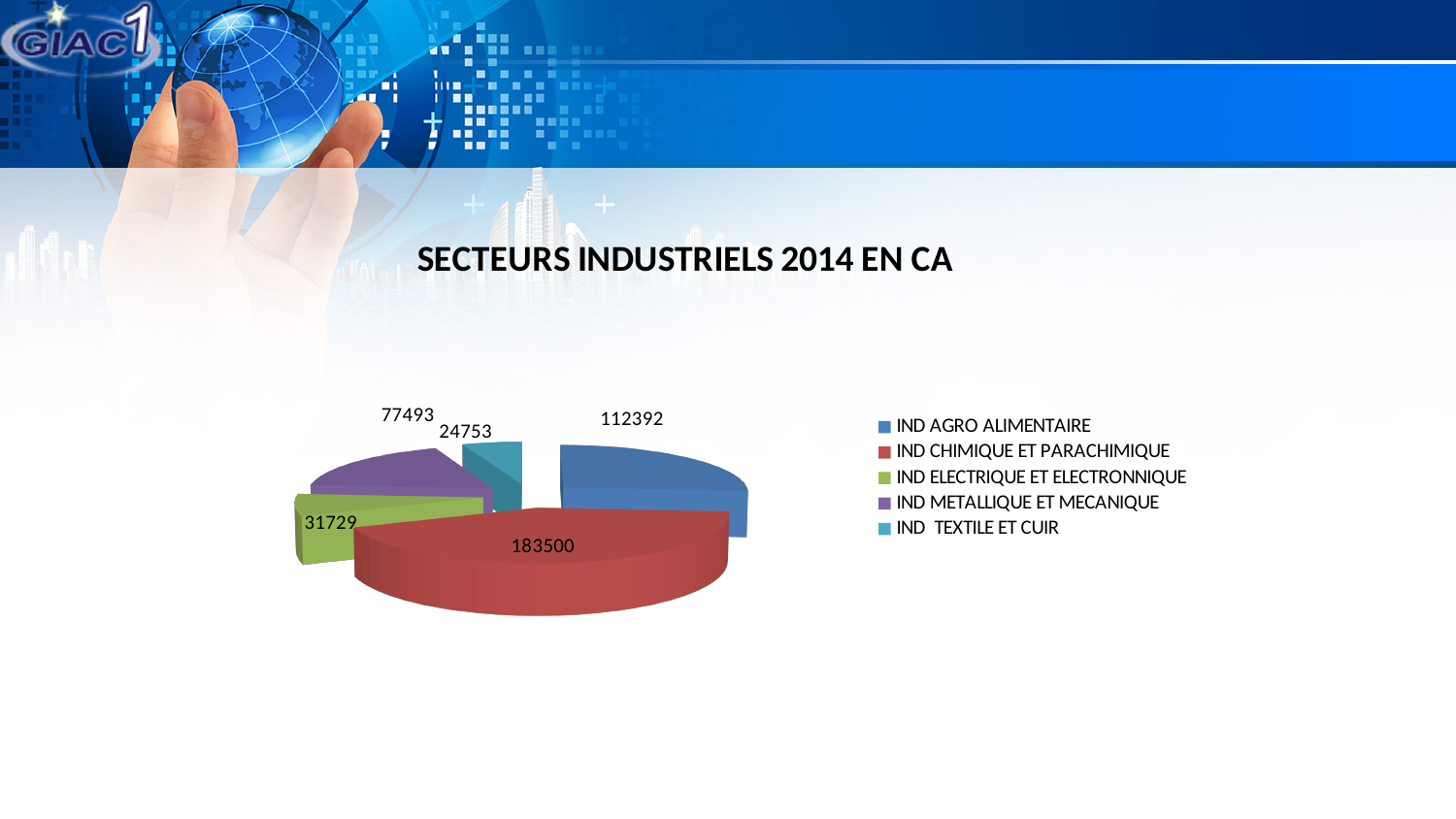
Which sector has the largest slice of the pie? IND CHIMIQUE ET PARACHIMIQUE What type of chart is shown on the slide? Pie chart What is the value for IND CHIMIQUE ET PARACHIMIQUE? 183500 Which sector has the smallest slice of the pie? IND TEXTILE ET CUIR What is the value for IND TEXTILE ET CUIR? 24753 What is the title of the chart? SECTEURS INDUSTRIELS 2014 EN CA What is the value for IND METALLIQUE ET MECANIQUE? 77493 What is the difference between the values for IND CHIMIQUE ET PARACHIMIQUE and IND AGRO ALIMENTAIRE? 71108 Which is larger, the value for IND METALLIQUE ET MECANIQUE or the value for IND ELECTRIQUE ET ELECTRONNIQUE? IND METALLIQUE ET MECANIQUE How many sectors are shown in the pie chart? 5 What colour is the slice for IND ELECTRIQUE ET ELECTRONNIQUE? Green What is the value for IND AGRO ALIMENTAIRE? 112392